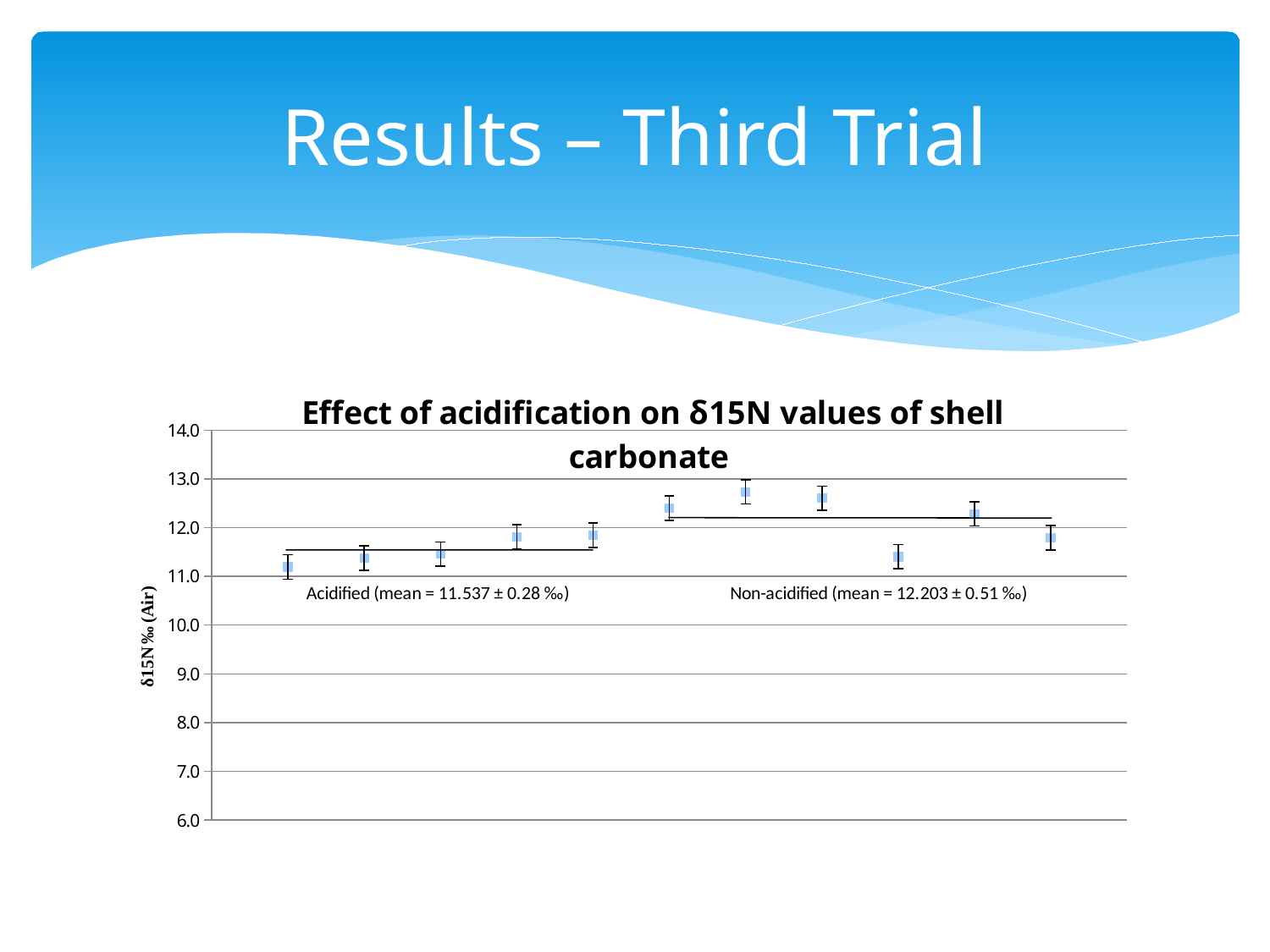
Is the lowest Acidified data point greater or less than 11.0? greater How many data points are plotted for the Acidified group? 5 What is the mean δ15N value for the Acidified group? 11.537 ± 0.28 ‰ Which group has the higher mean δ15N value, Acidified or Non-acidified? Non-acidified What is the label on the vertical axis of the chart? δ15N ‰ (Air) What is the title of the chart? Effect of acidification on δ15N values of shell carbonate How many data points are plotted in total on the chart? 11 What is the mean δ15N value for the Non-acidified group? 12.203 ± 0.51 ‰ Are all of the Acidified data points greater or less than 12.0? less What is the difference between the Non-acidified mean (12.203 ‰) and the Acidified mean (11.537 ‰)? 0.666 ‰ Is the highest Non-acidified data point greater or less than 12.5? greater What kind of chart is shown on the slide? Scatter chart